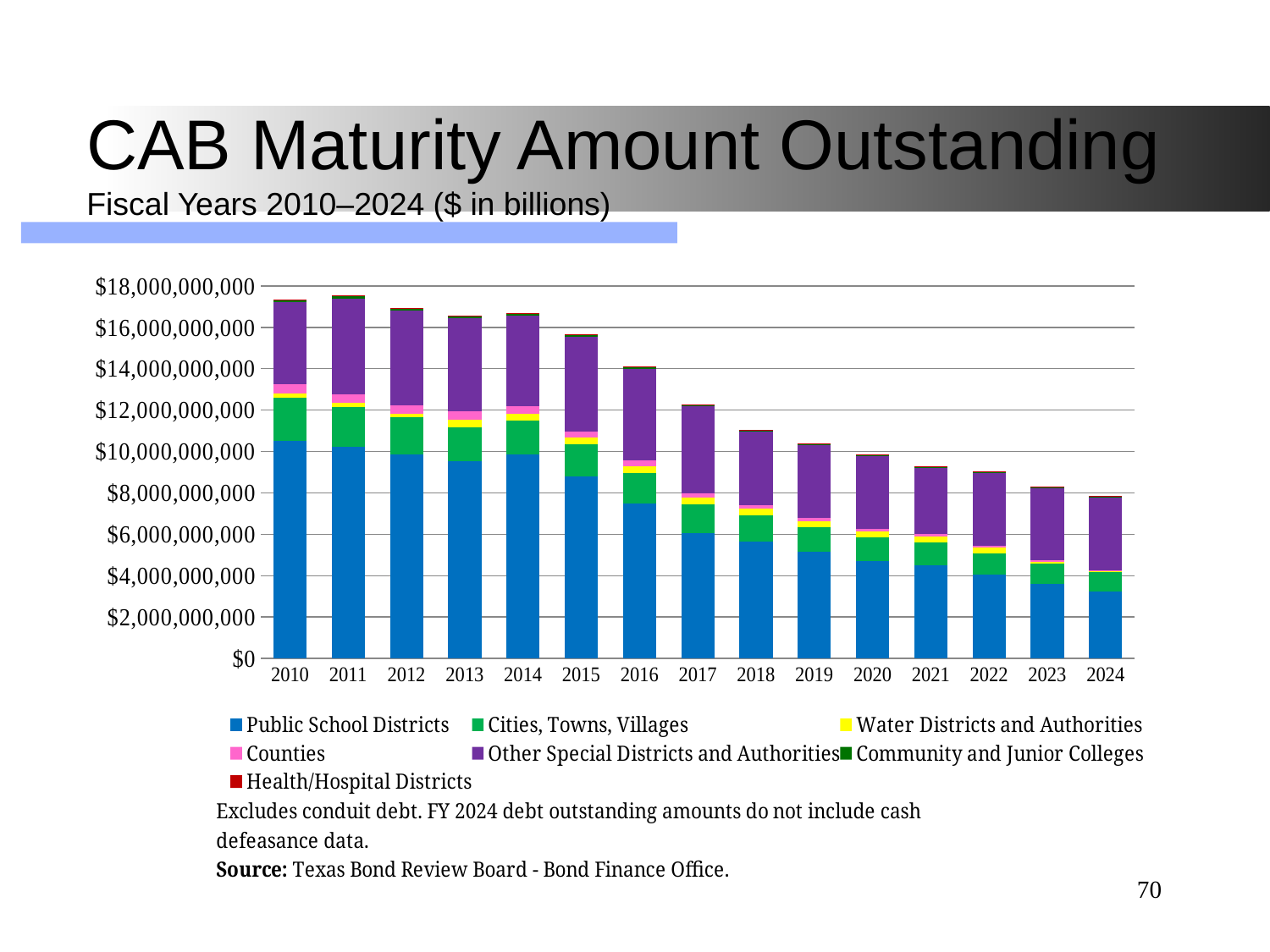
Which series is shown in purple in the chart? Other Special Districts and Authorities Is the Public School Districts value for 2010 greater or less than $10,000,000,000? greater What kind of chart is shown on the slide? Stacked bar chart Is the total bar for 2016 greater or less than $12,000,000,000? greater What is the subtitle of the chart on the slide? Fiscal Years 2010–2024 ($ in billions) Which year has a larger total bar, 2010 or 2015? 2010 How many fiscal years are shown on the x axis of the chart? 15 How many series does the chart's legend list? 7 Is the Public School Districts value for 2024 greater or less than $4,000,000,000? less Which fiscal year has the lowest total CAB maturity amount outstanding? 2024 Do the total bar heights generally rise or fall from 2010 to 2024? Fall